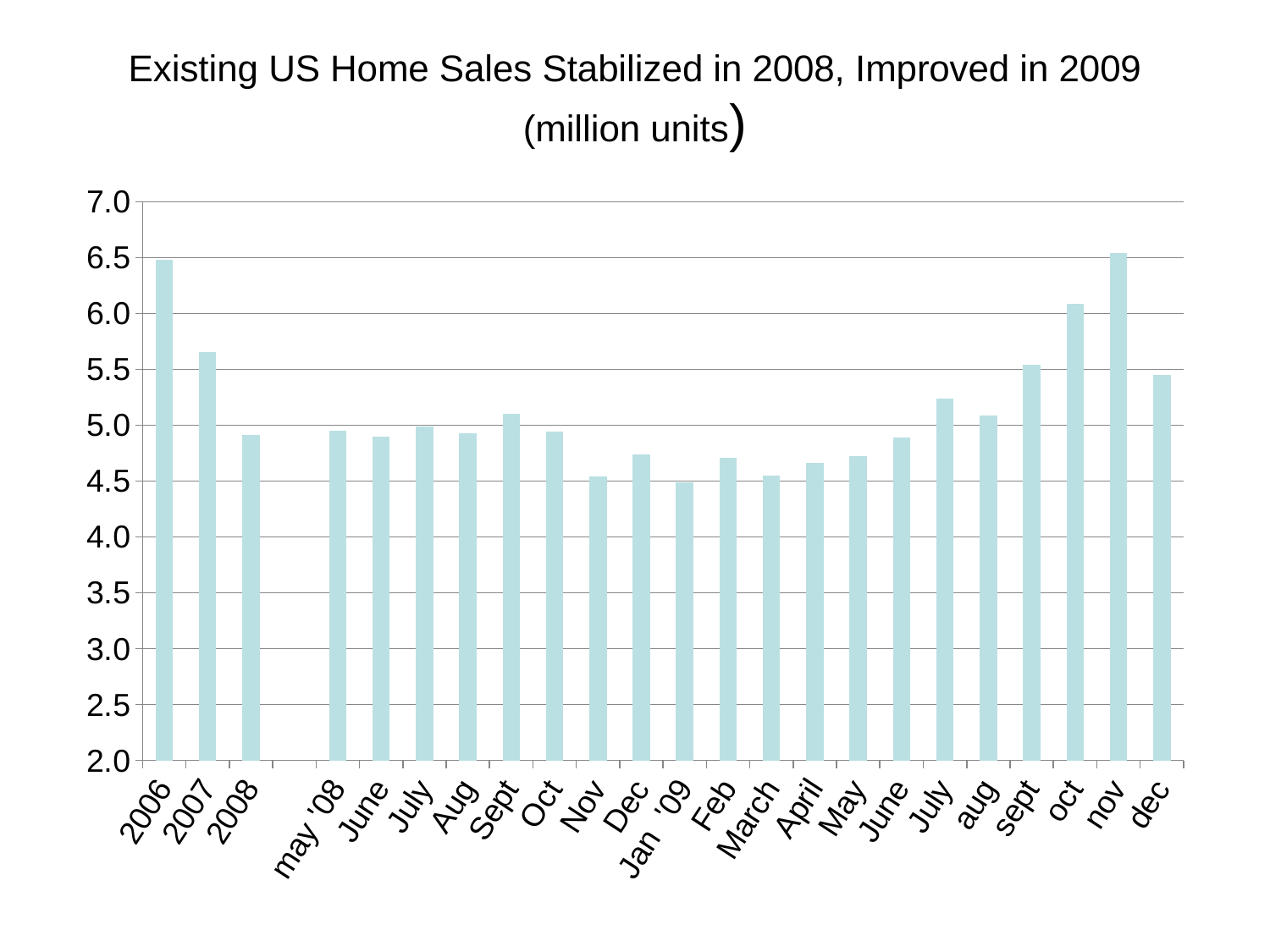
In what units are the values on the chart expressed? million units Is the value for 2008 greater or less than 5.0? less Is the value for 2006 greater or less than 6.0? greater Do the values generally rise or fall from Jan '09 to nov? rise What is the title of the chart? Existing US Home Sales Stabilized in 2008, Improved in 2009 (million units) What kind of chart is shown on the slide? bar chart Which is larger, the value for 2006 or the value for 2008? 2006 Is the value for Jan '09 greater or less than 5.0? less How many bars are plotted on the chart? 23 Which is larger, the value for oct or the value for Jan '09? oct